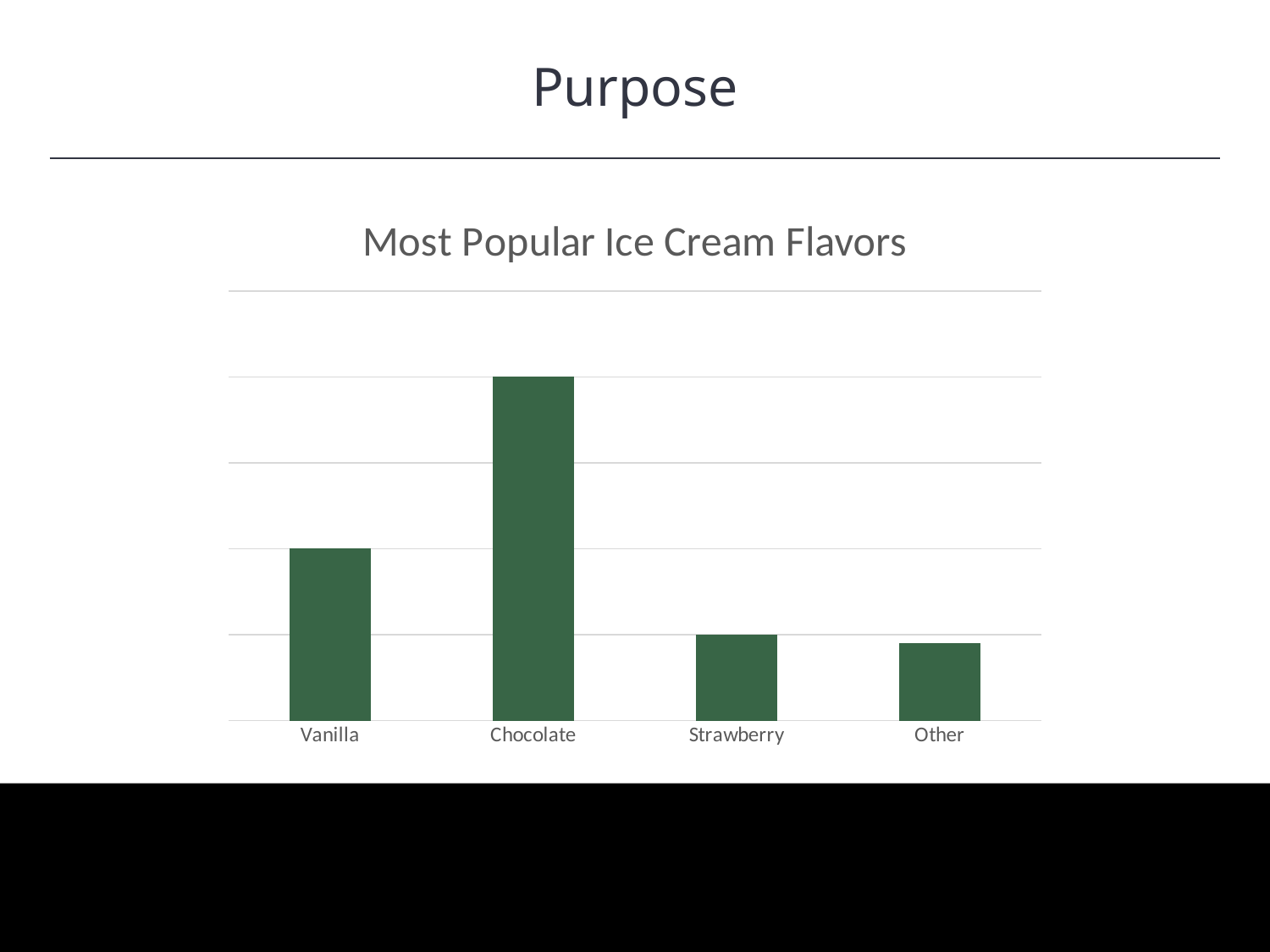
Which flavor has the highest bar in the chart? Chocolate How many flavor categories are shown in the chart? 4 Which is larger, the value for Chocolate or the value for Other? Chocolate What colour are the bars in the chart? green What is the title of the chart? Most Popular Ice Cream Flavors Which is larger, the value for Vanilla or the value for Chocolate? Chocolate What type of chart is shown on the slide? bar chart Which is larger, the value for Vanilla or the value for Other? Vanilla